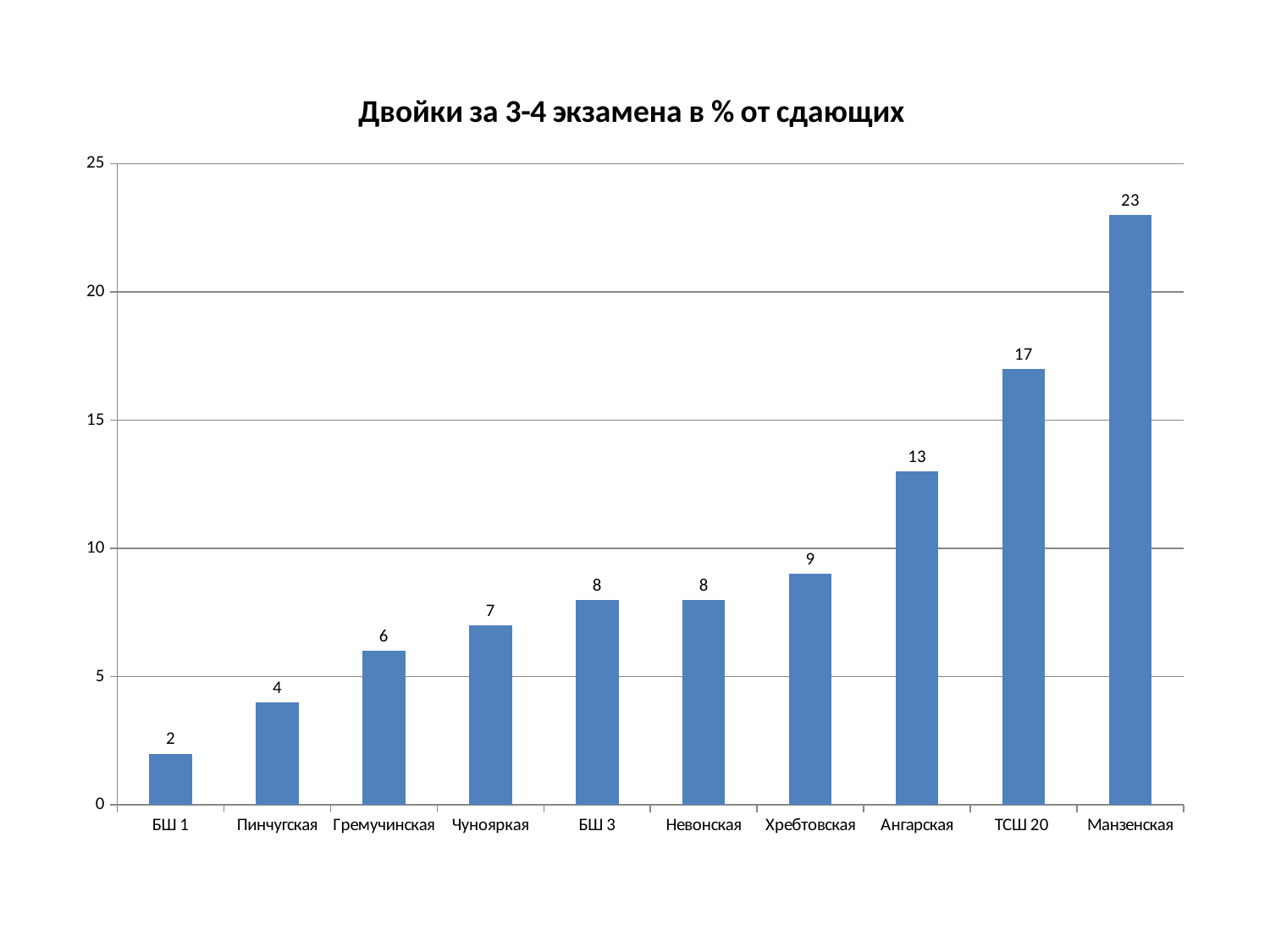
Which is larger, the value for Хребтовская or the value for Пинчугская? Хребтовская What is the difference between the values for Манзенская and ТСШ 20? 6 What kind of chart is shown on the slide? bar chart What is the value for Гремучинская? 6 Is the value for ТСШ 20 greater or less than 15? greater Which category has the highest value? Манзенская Which category has the lowest value? БШ 1 Do the values rise or fall from left to right along the x axis? rise What is the value for Чуноярская? 7 What is the title of the chart? Двойки за 3-4 экзамена в % от сдающих What is the value for Ангарская? 13 How many categories are shown on the x axis? 10